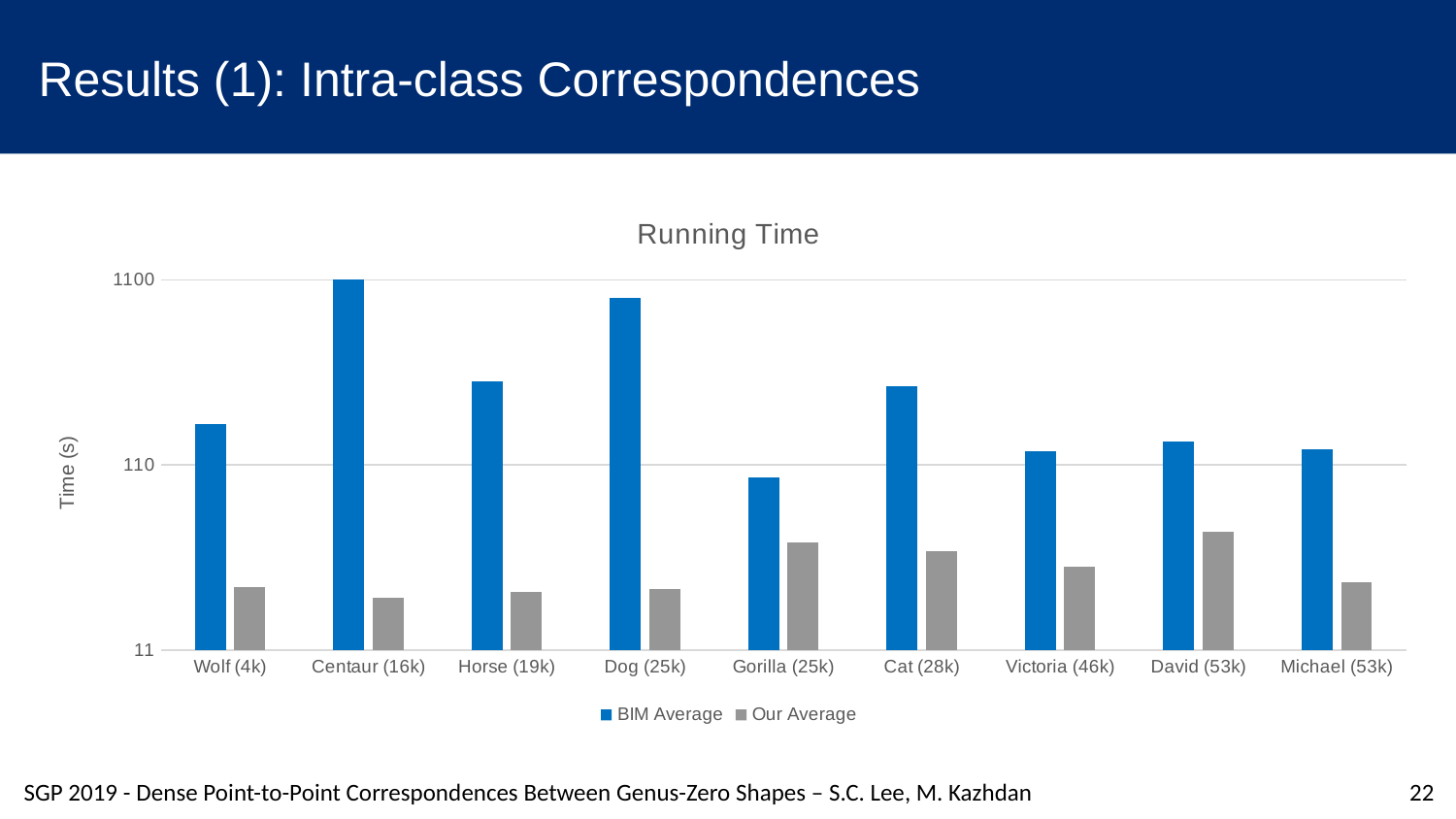
What kind of chart is shown on the slide? bar chart What is the label of the y axis? Time (s) What is the title of the chart? Running Time Which has the larger BIM Average: Centaur (16k) or Horse (19k)? Centaur (16k) Which category has the highest BIM Average running time? Centaur (16k) Which category has the lowest BIM Average running time? Gorilla (25k) Is the BIM Average value for Wolf (4k) greater or less than 110? greater How many categories (shapes) are shown on the x axis? 9 How many series does the legend list? 2 Which is larger for Dog (25k): the BIM Average or Our Average? BIM Average Is the Our Average value for Cat (28k) greater or less than 110? less Which category has the highest Our Average running time? David (53k)